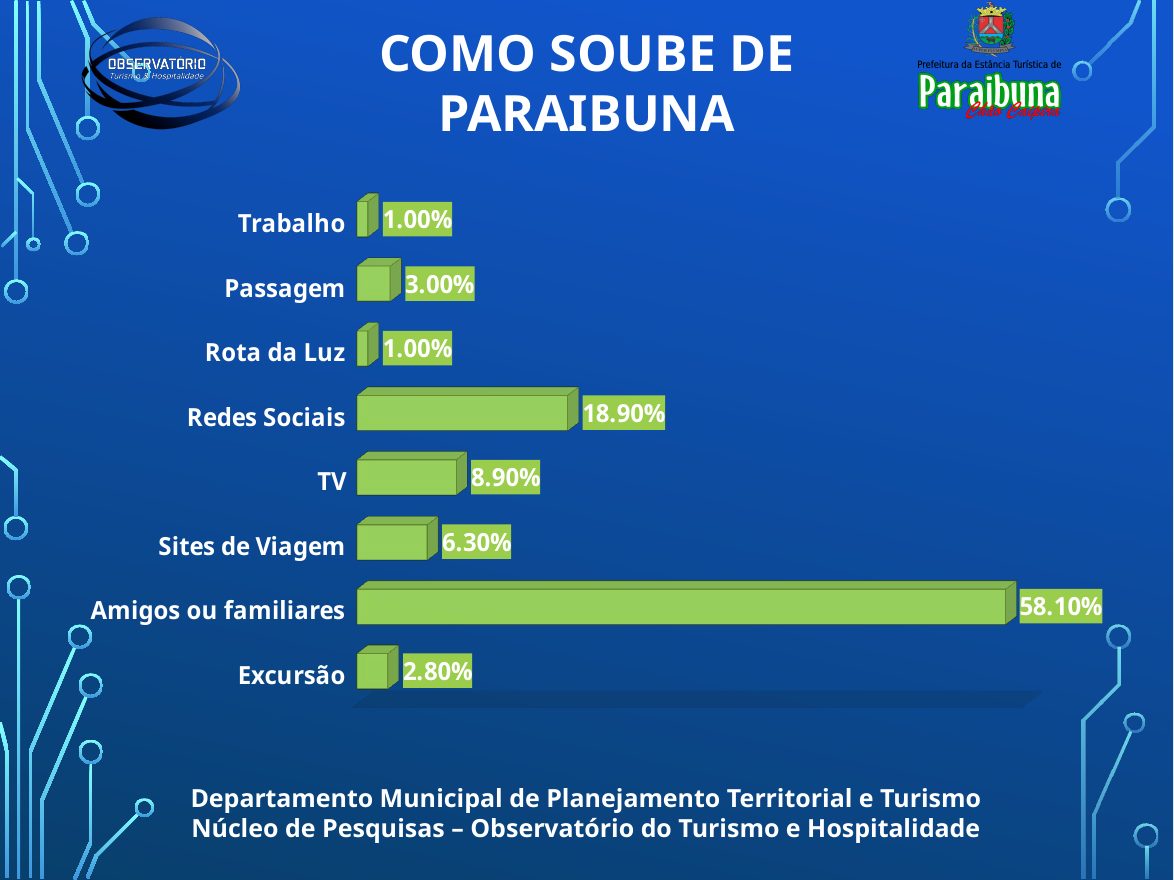
What is the value for Amigos ou familiares? 58.10% Which is larger, the value for Sites de Viagem or the value for Passagem? Sites de Viagem How many categories are shown in the chart? 8 What is the title of the chart? COMO SOUBE DE PARAIBUNA Which categories share the lowest value of 1.00%? Trabalho and Rota da Luz What kind of chart is shown on the slide? Bar chart What is the difference between the values for Amigos ou familiares and Redes Sociais? 39.20% What is the value for Excursão? 2.80% Which category has the highest value? Amigos ou familiares What is the value for Redes Sociais? 18.90% What is the value for TV? 8.90% What is the difference between the values for Redes Sociais and TV? 10.00%